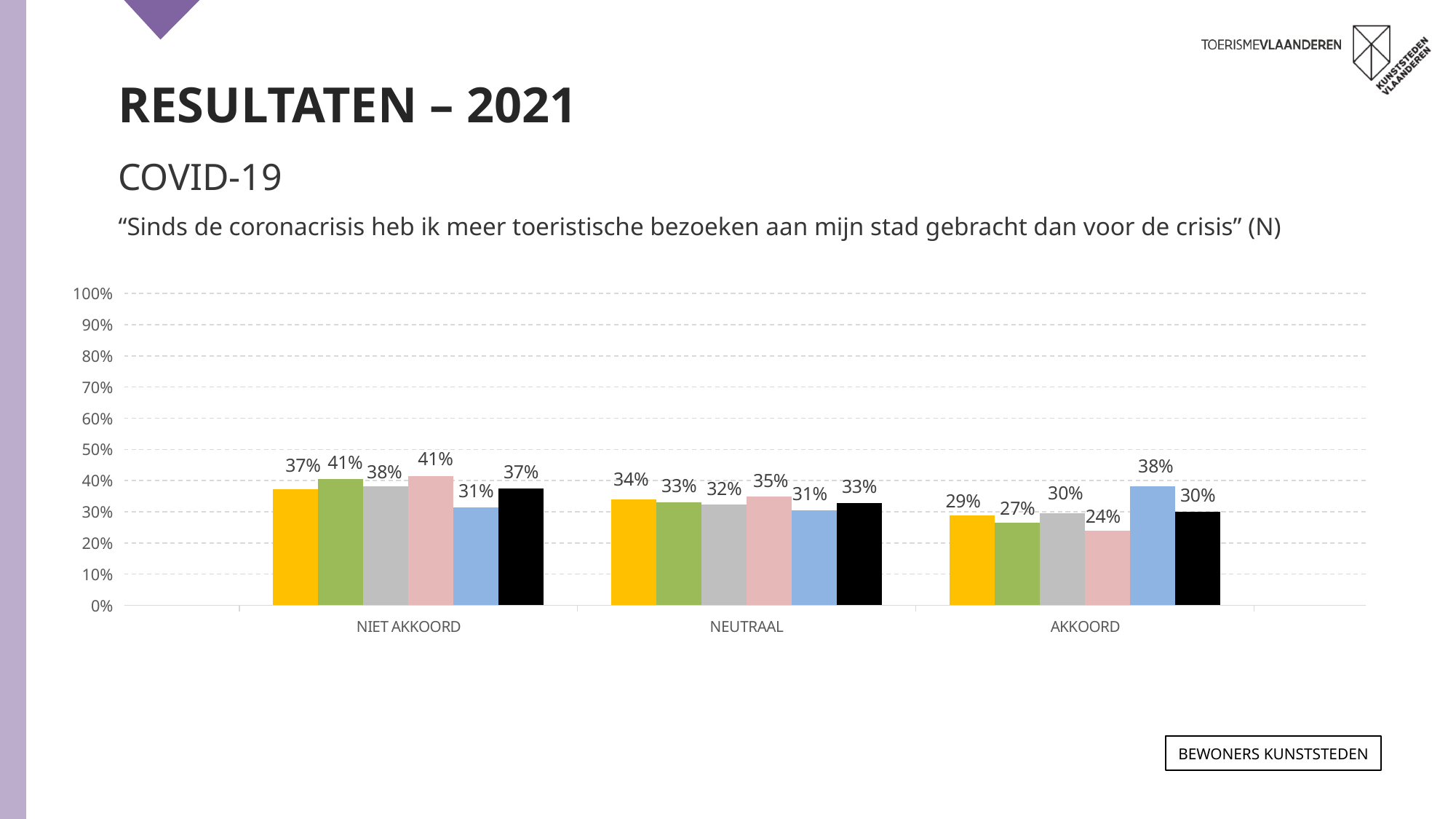
How many bars are shown in each category group? 6 What is the difference between the blue bar and the pink bar for AKKOORD? 14% Which bar has the highest value in the AKKOORD category? the blue bar (38%) Which bar has the lowest value in the AKKOORD category? the pink bar (24%) Which is larger for NIET AKKOORD: the green bar or the blue bar? the green bar (41%) What is the value of the pink bar for NEUTRAAL? 35% How many categories are shown on the x axis of the chart? 3 What is the value of the blue bar for AKKOORD? 38% What is the value of the black bar for AKKOORD? 30% What type of chart is shown on the slide? bar chart What is the value of the yellow bar for NIET AKKOORD? 37% Is the value of the pink bar for NIET AKKOORD greater or less than 30%? greater